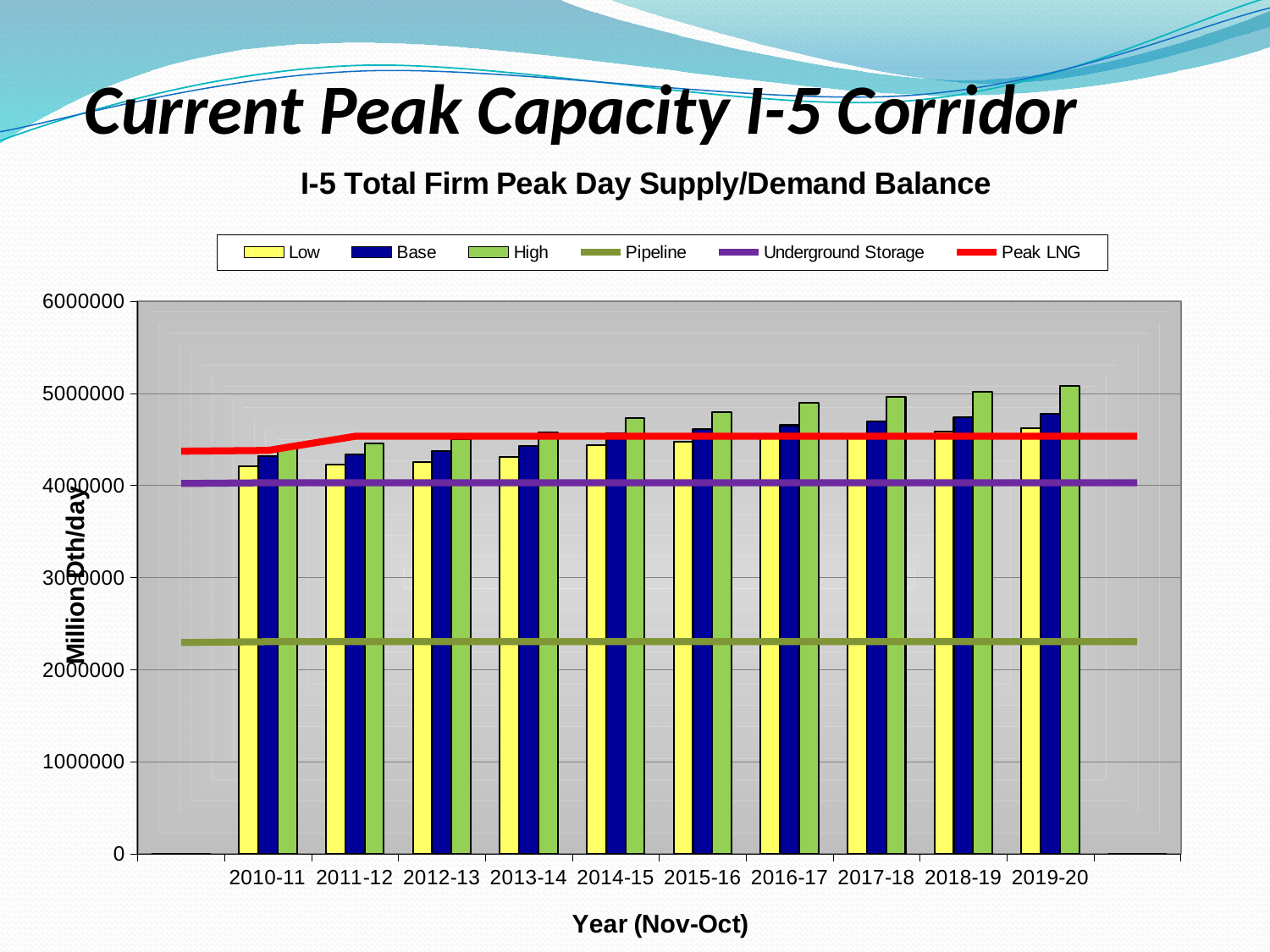
Do the High bars rise or fall from 2010-11 to 2019-20? Rise Is the Pipeline line greater or less than 3000000? less What kind of chart is shown on the slide? Bar chart with line series In which year is the Low bar the shortest? 2010-11 Is the Low value for 2010-11 greater or less than 4000000? greater How many series does the chart legend list? 6 In which year is the High bar the tallest? 2019-20 Is the Peak LNG line greater or less than 5000000? less What is the label on the x axis of the chart? Year (Nov-Oct) How many years are shown on the x axis of the chart? 10 Which is higher on the chart, the Pipeline line or the Underground Storage line? Underground Storage What is the title of the chart? I-5 Total Firm Peak Day Supply/Demand Balance